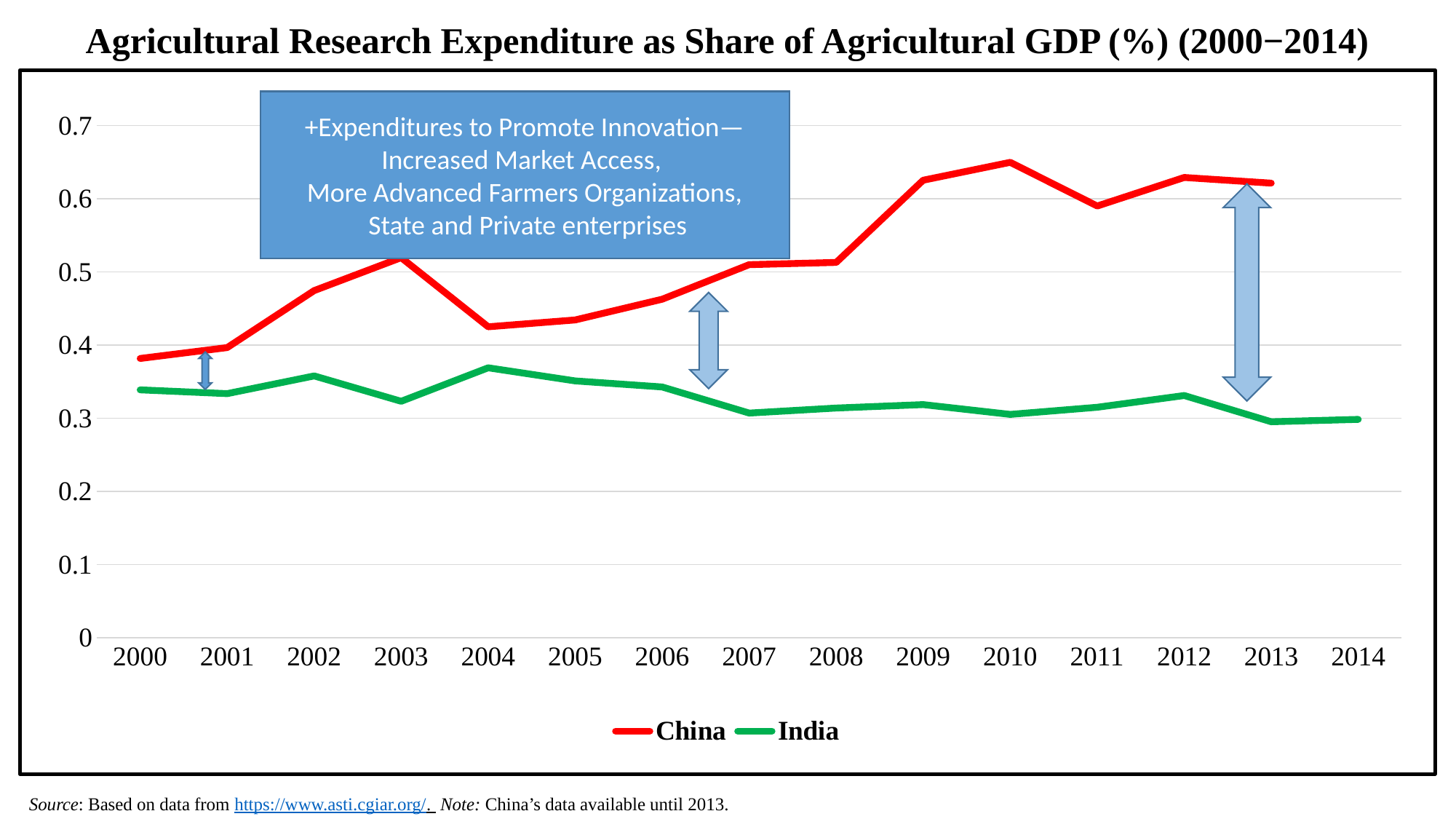
Which colour is used for the India line? green Does the India line rise or fall between 2004 and 2007? fall Which country has the higher value in 2009, China or India? China Is the value for China in 2003 greater or less than 0.5? greater How many series does the legend list? 2 Is the value for China in 2010 greater or less than 0.6? greater Is the value for China in 2000 greater or less than 0.4? less According to the note, until which year is China's data available? 2013 How many years are shown on the x axis? 15 In which year does the China line reach its highest value? 2010 What kind of chart is shown on the slide? line chart